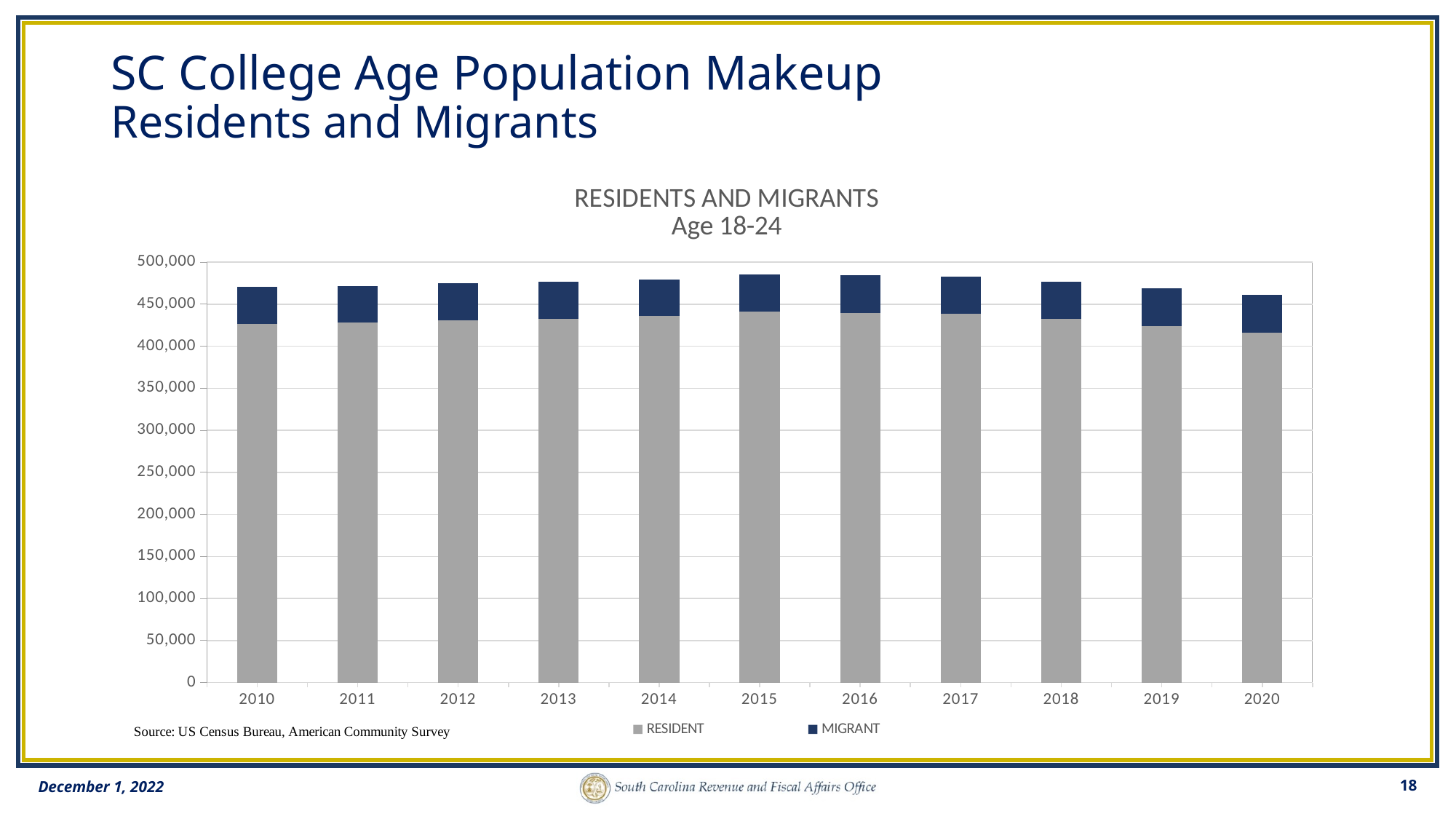
Is the RESIDENT value for 2020 greater or less than 400,000? greater Which year has the lowest total bar (residents plus migrants)? 2020 What are the two entries in the chart's legend? RESIDENT and MIGRANT What kind of chart is shown on the slide? Stacked bar chart Is the total bar for 2015 greater or less than 450,000? greater How many series does the chart's legend list? 2 Which year has the lowest RESIDENT value? 2020 Which is larger, the RESIDENT value for 2010 or the RESIDENT value for 2020? 2010 How many years are shown along the x axis of the chart? 11 From 2015 to 2020, do the total bars rise or fall? fall Is the total bar for 2020 greater or less than 500,000? less Which is larger, the total bar for 2015 or the total bar for 2020? 2015